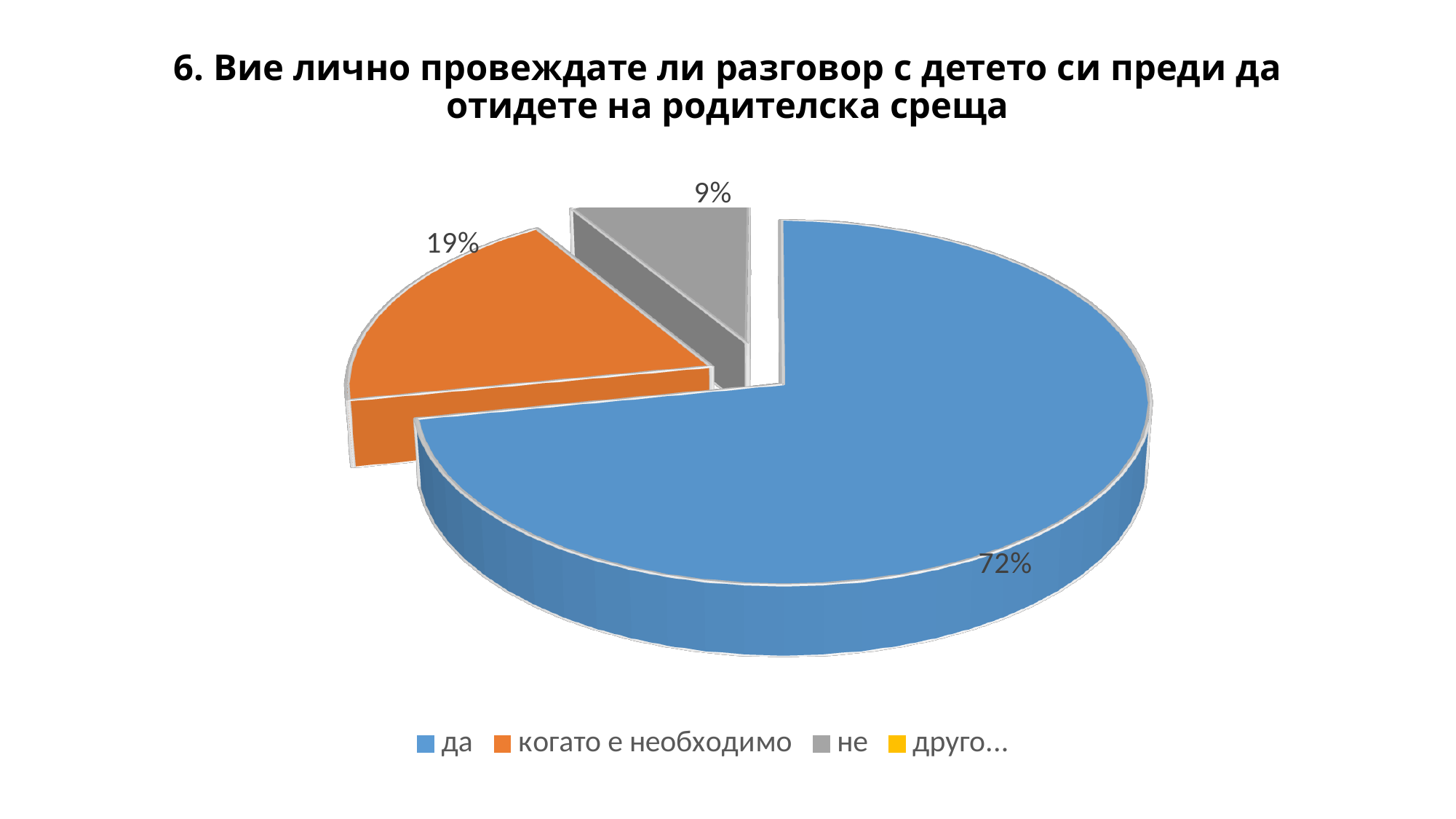
Which category has the largest share of the pie? да What is the difference between the "когато е необходимо" share and the "не" share? 10 percentage points What percentage is shown for the "да" slice? 72% What percentage is shown for the "когато е необходимо" slice? 19% How many entries does the legend list? 4 What percentage is shown for the "не" slice? 9% Which labelled slice has the smallest share of the pie? не Which is larger, the share for "когато е необходимо" or the share for "не"? когато е необходимо What colour is the "да" slice? blue Which legend entry is shown in orange? когато е необходимо What is the difference between the "да" share and the "когато е необходимо" share? 53 percentage points What kind of chart is shown on the slide? pie chart